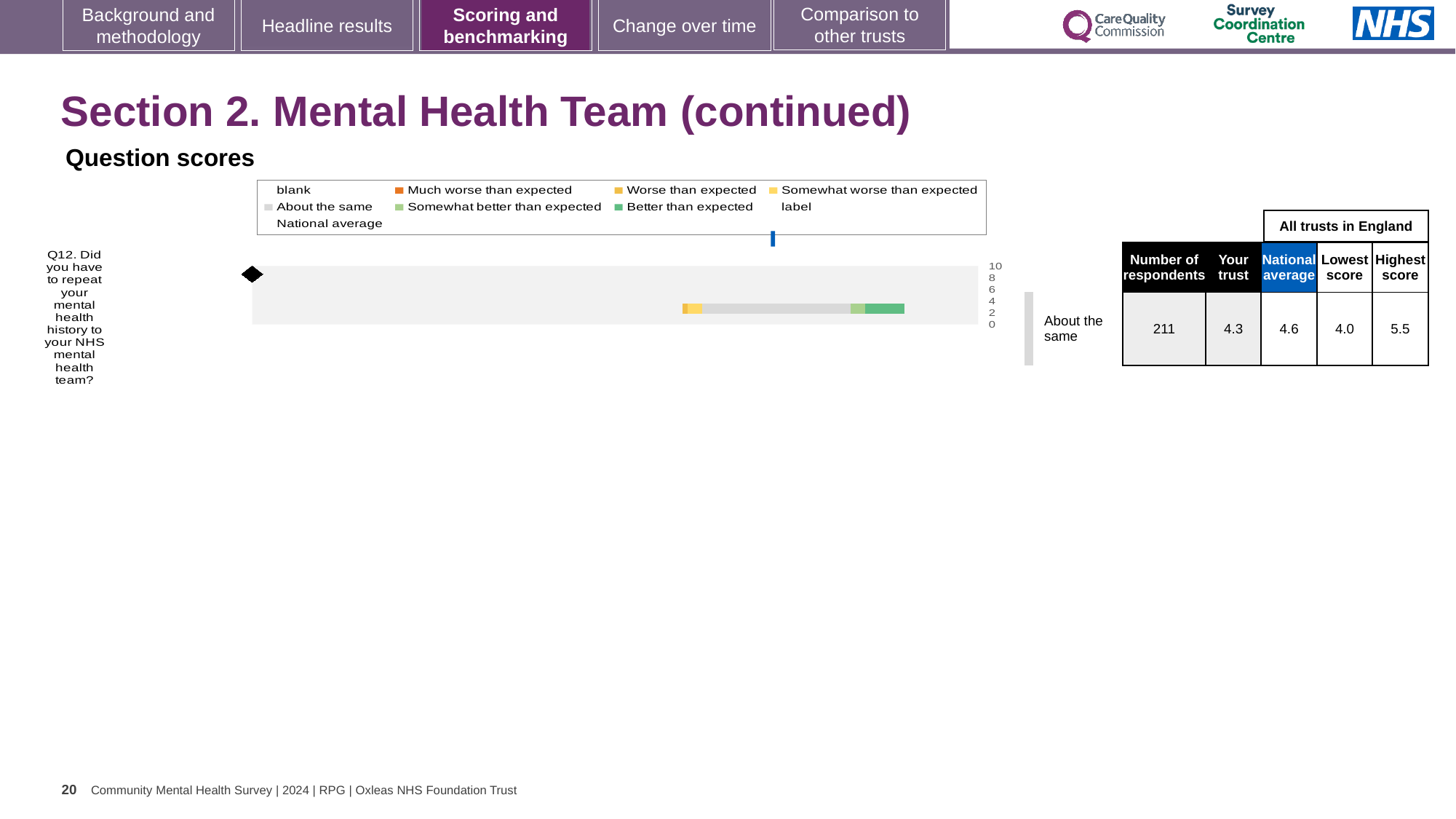
How is the trust's Q12 score categorised relative to what is expected? About the same What is the lowest score among all trusts in England for Q12? 4.0 Which is larger for Q12: the trust's score or the national average? National average What is the trust's score for Q12 (Did you have to repeat your mental health history to your NHS mental health team?)? 4.3 How many questions are plotted on the chart? 1 Which legend entry is shown in dark green? Better than expected How many respondents answered Q12? 211 What is the national average score shown for Q12? 4.6 What is the difference between the national average and the trust's score for Q12? 0.3 What is the difference between the highest and lowest scores across all trusts in England for Q12? 1.5 What is the highest score among all trusts in England for Q12? 5.5 What kind of chart is used to show the Q12 benchmarking result? Bar chart